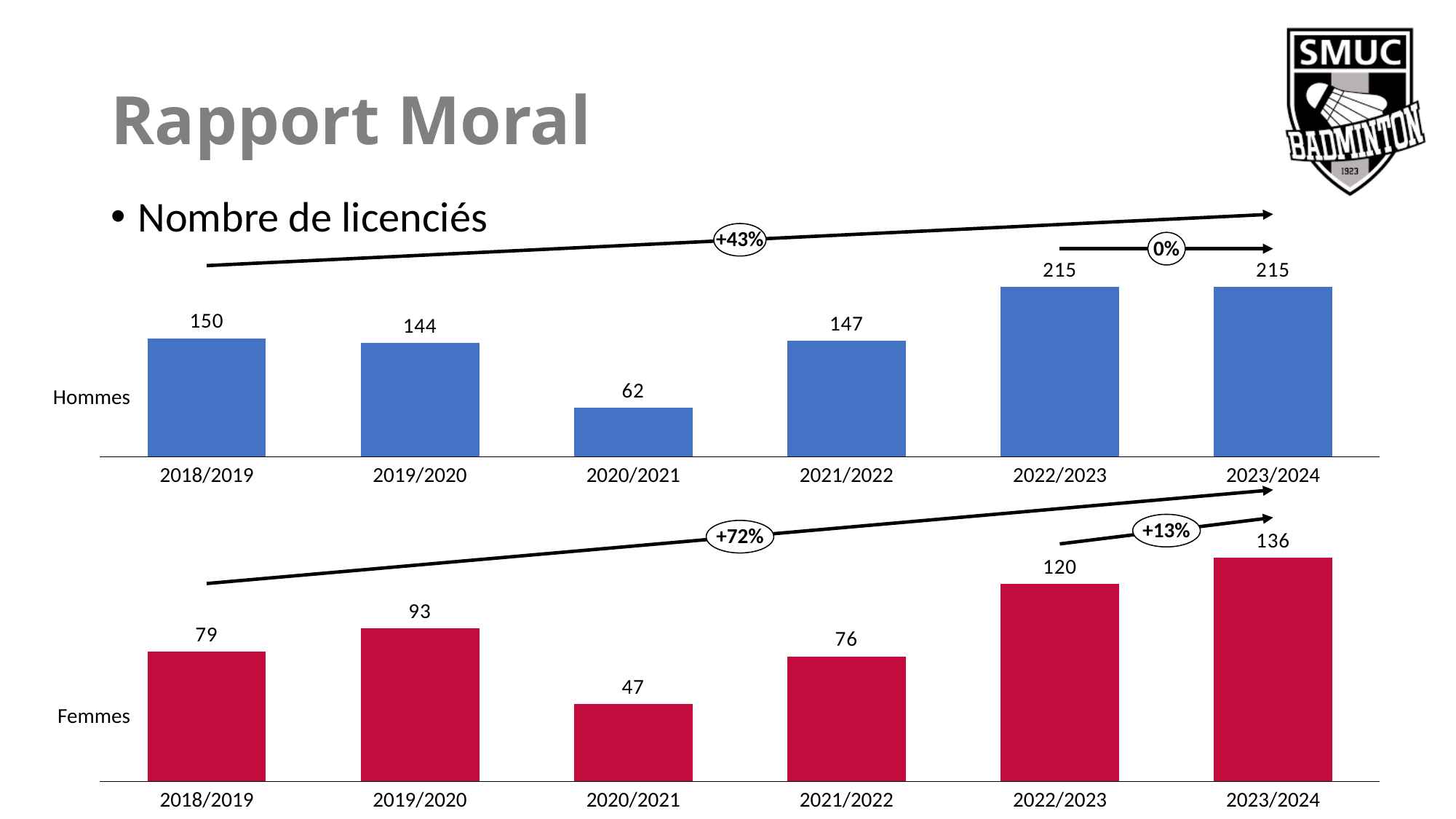
In the Femmes chart, what is the value for 2023/2024? 136 In the Hommes chart, does the value rise or fall from 2020/2021 to 2021/2022? rise How many seasons are shown on the x axis of the Hommes chart? 6 In the Femmes chart, which season has the highest value? 2023/2024 In the Hommes chart, what is the value for 2019/2020? 144 In the Hommes chart, which season has the lowest value? 2020/2021 In the Hommes chart, what is the value for 2020/2021? 62 In the Hommes chart, what is the difference between the values for 2022/2023 and 2021/2022? 68 What colour are the bars in the Femmes chart? red What kind of chart is the Femmes chart? bar chart In the Femmes chart, what is the difference between the values for 2019/2020 and 2018/2019? 14 In the Femmes chart, which is larger, the value for 2021/2022 or the value for 2019/2020? 2019/2020